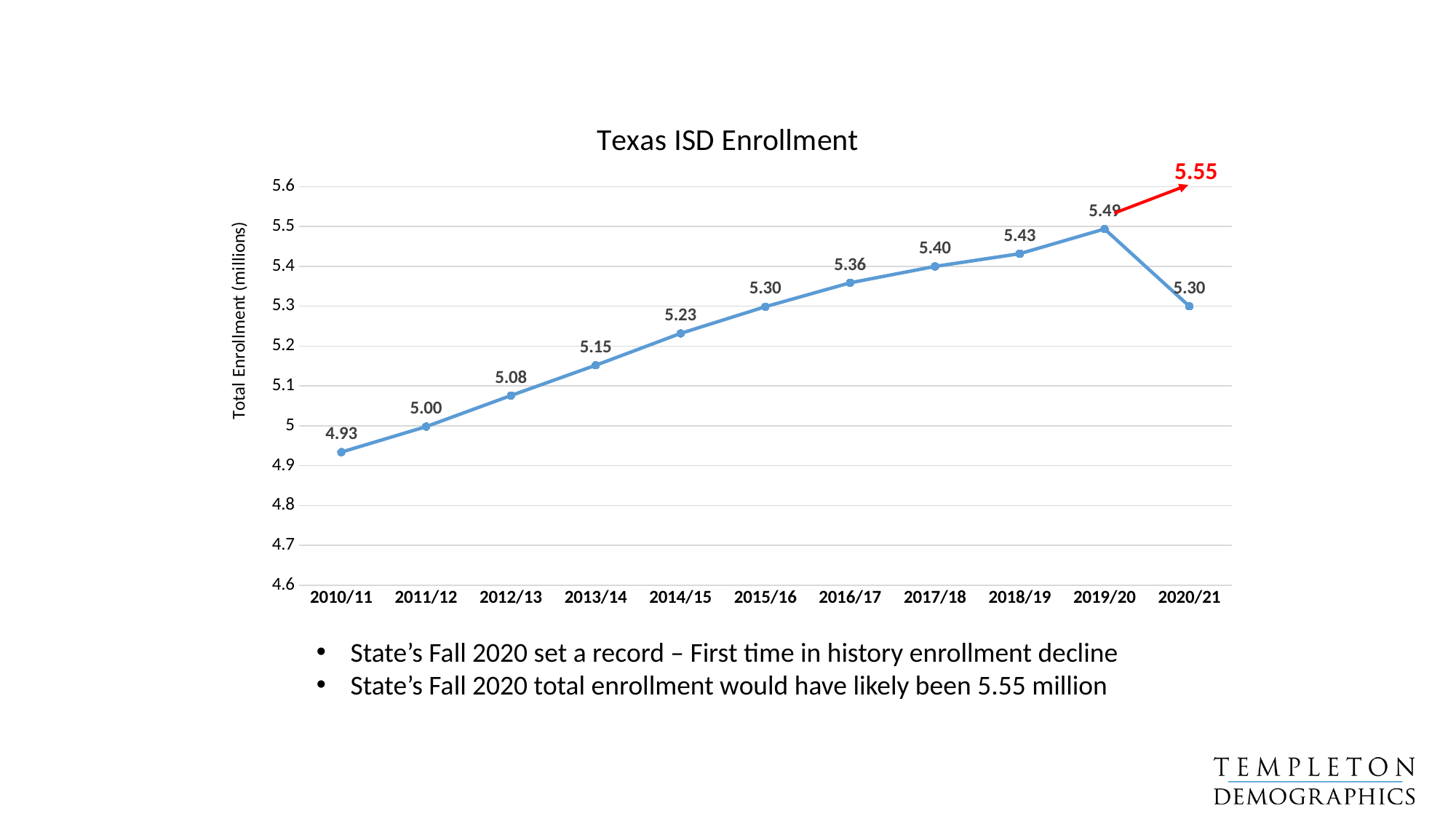
What type of chart is shown on the slide? line chart What is the title of the chart? Texas ISD Enrollment What is the total enrollment value for 2019/20? 5.49 What is the total enrollment value for 2010/11? 4.93 Which school year has the highest plotted enrollment value? 2019/20 Which is larger, the enrollment value for 2014/15 or for 2017/18? 2017/18 What is the total enrollment value for 2020/21? 5.30 What is the label on the y axis? Total Enrollment (millions) What is the difference between the enrollment values for 2019/20 and 2020/21? 0.19 Which school year has the lowest plotted enrollment value? 2010/11 How many school years are plotted on the x axis? 11 Does enrollment rise or fall from 2010/11 to 2019/20? rise